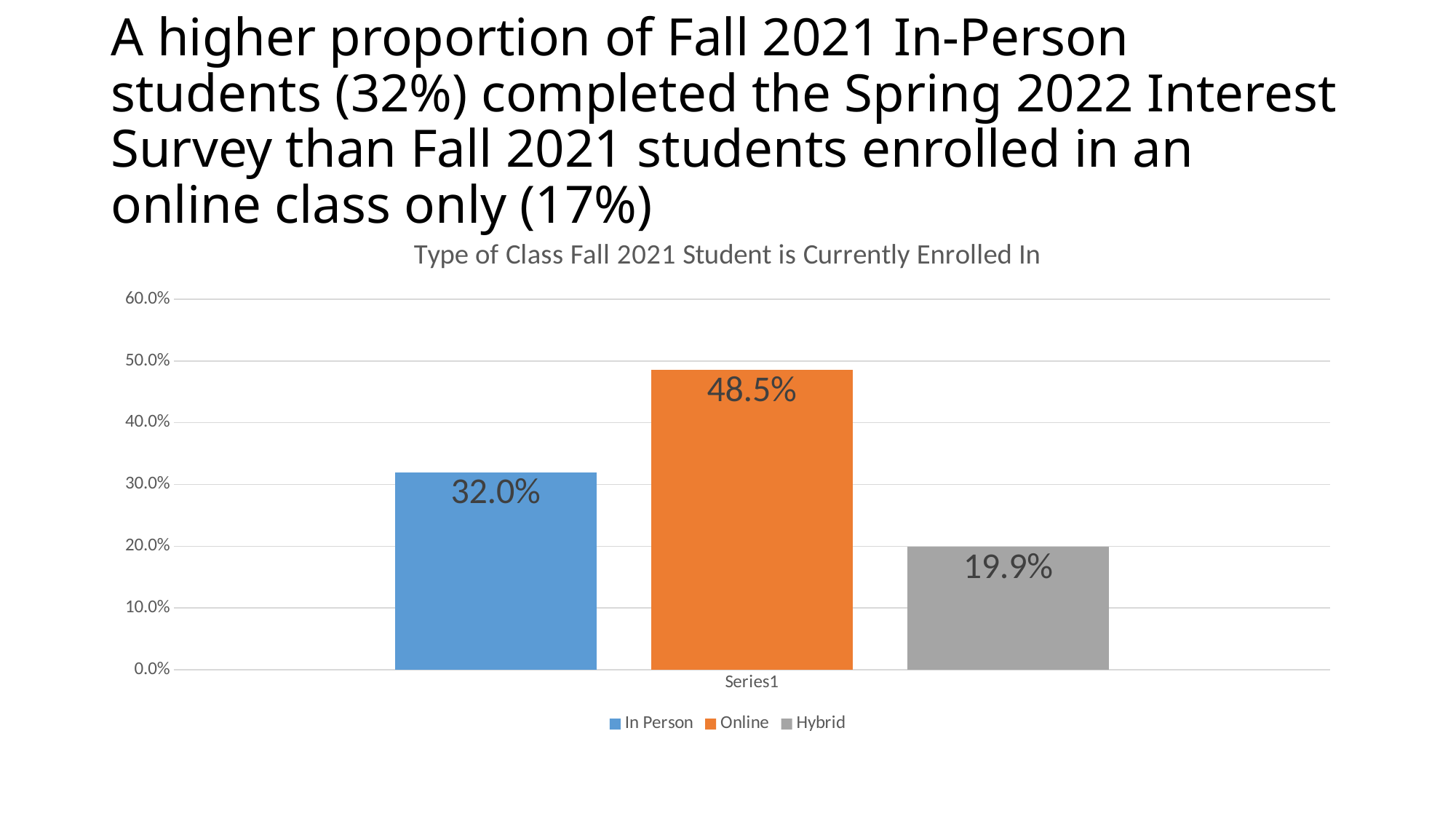
Which is larger, the value for In Person or the value for Hybrid? In Person What is the value for Hybrid? 19.9% What is the value for Online? 48.5% Which class type has the highest value? Online What is the title of the chart? Type of Class Fall 2021 Student is Currently Enrolled In Which class type has the lowest value? Hybrid What is the value for In Person? 32.0% How many series does the legend list? 3 What is the difference between the Online and In Person values? 16.5% What kind of chart is shown? bar chart What is the difference between the In Person and Hybrid values? 12.1% Is the value for Online greater or less than 40.0%? greater